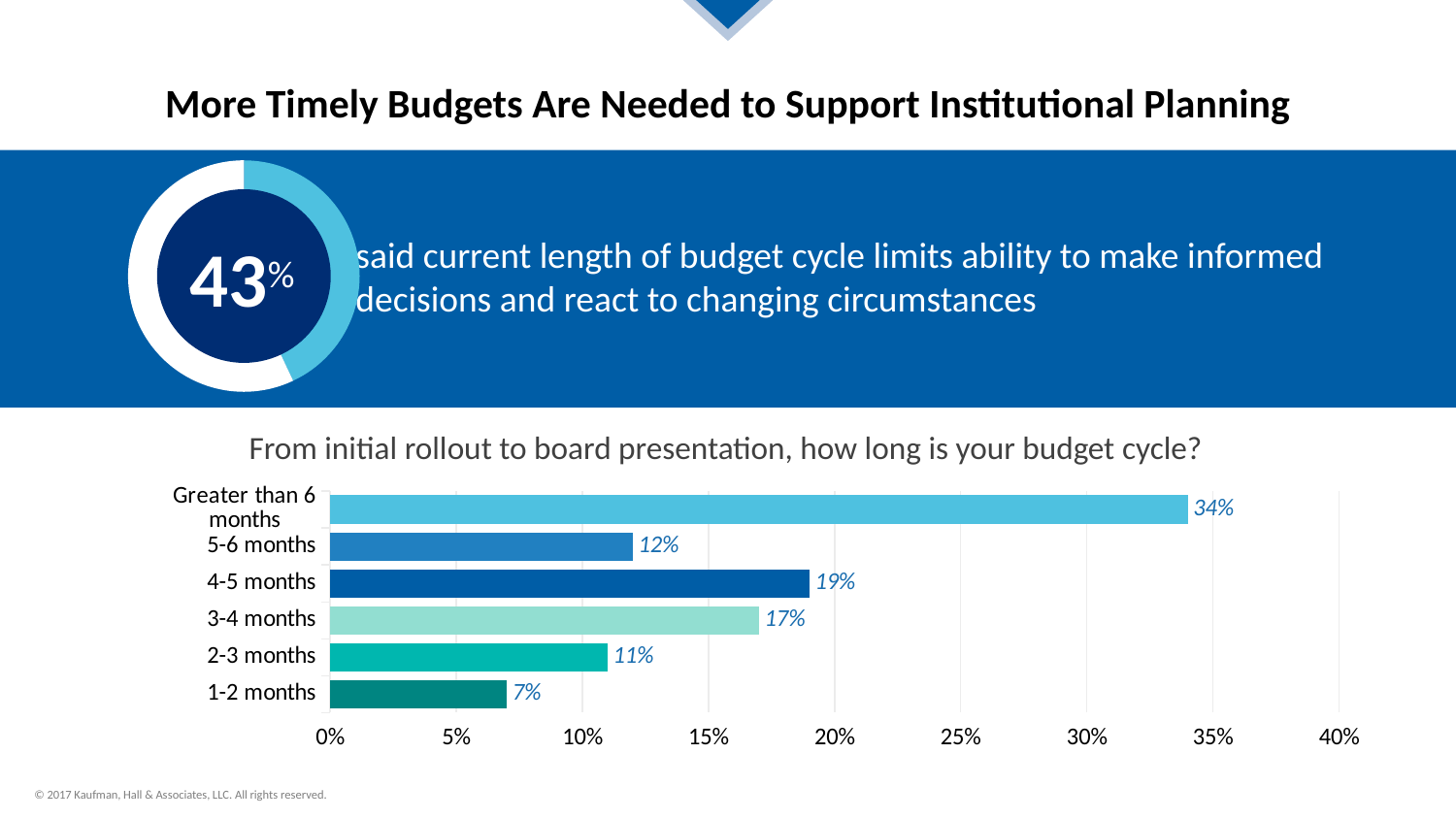
How many budget cycle length categories are shown in the bar chart 'From initial rollout to board presentation, how long is your budget cycle?'? 6 In the bar chart 'From initial rollout to board presentation, how long is your budget cycle?', what percentage of respondents have a budget cycle of greater than 6 months? 34% In the bar chart 'From initial rollout to board presentation, how long is your budget cycle?', what is the value for 4-5 months? 19% In the bar chart 'From initial rollout to board presentation, how long is your budget cycle?', is the value for 3-4 months greater or less than 15%? greater In the bar chart 'From initial rollout to board presentation, how long is your budget cycle?', which budget cycle length has the lowest percentage? 1-2 months What kind of chart is used to show the answers to 'From initial rollout to board presentation, how long is your budget cycle?'? Bar chart What percentage is shown in the donut chart in the blue band near the top of the slide? 43% In the bar chart 'From initial rollout to board presentation, how long is your budget cycle?', what is the difference between the values for 4-5 months and 3-4 months? 2% In the bar chart 'From initial rollout to board presentation, how long is your budget cycle?', which budget cycle length has the highest percentage? Greater than 6 months In the bar chart 'From initial rollout to board presentation, how long is your budget cycle?', what is the maximum value shown on the horizontal axis? 40% In the bar chart 'From initial rollout to board presentation, how long is your budget cycle?', what is the value for 1-2 months? 7% In the bar chart 'From initial rollout to board presentation, how long is your budget cycle?', which is larger: the value for 5-6 months or the value for 2-3 months? 5-6 months